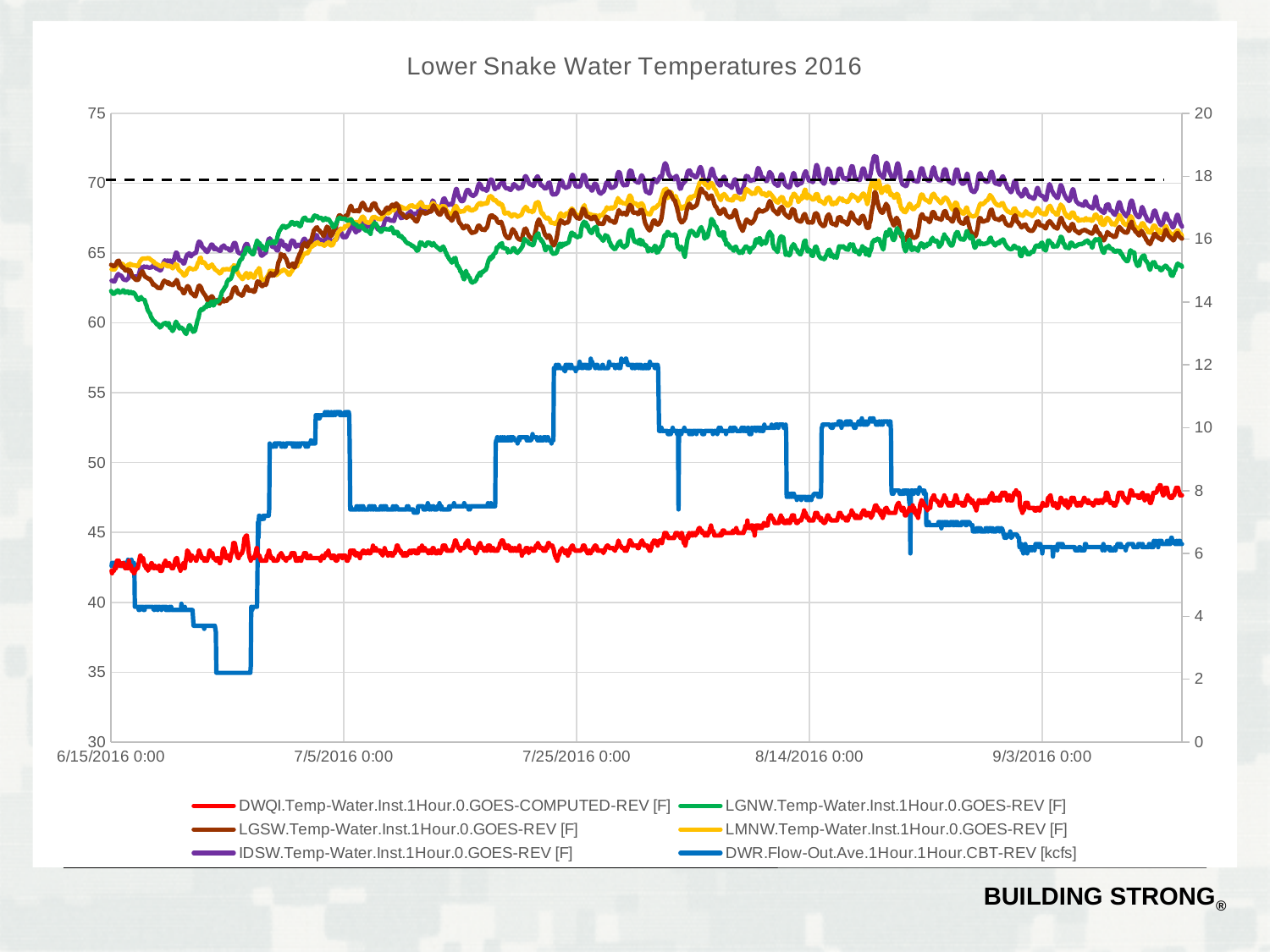
Which series is plotted in blue and measured in kcfs? DWR.Flow-Out.Ave.1Hour.1Hour.CBT-REV [kcfs] Is the DWR.Flow-Out value (blue line, right axis) at 7/25/2016 0:00 greater or less than 10? greater What kind of chart is shown on the slide? line chart Is the value of DWQI.Temp-Water (red line) at the right end of the chart greater or less than 50? less Which temperature series has the lowest values on the chart? DWQI.Temp-Water.Inst.1Hour.0.GOES-COMPUTED-REV [F] Does the DWQI.Temp-Water (red line) generally rise or fall from 6/15/2016 to the end of the chart? rise Which temperature series reaches the highest value on the chart? IDSW.Temp-Water.Inst.1Hour.0.GOES-REV [F] Is the value of LGNW.Temp-Water (green line) at 6/15/2016 0:00 greater or less than 60? greater What is the title of the chart? Lower Snake Water Temperatures 2016 How many series does the legend list? 6 At 7/25/2016 0:00, which is higher: IDSW.Temp-Water (purple) or LGNW.Temp-Water (green)? IDSW.Temp-Water (purple)